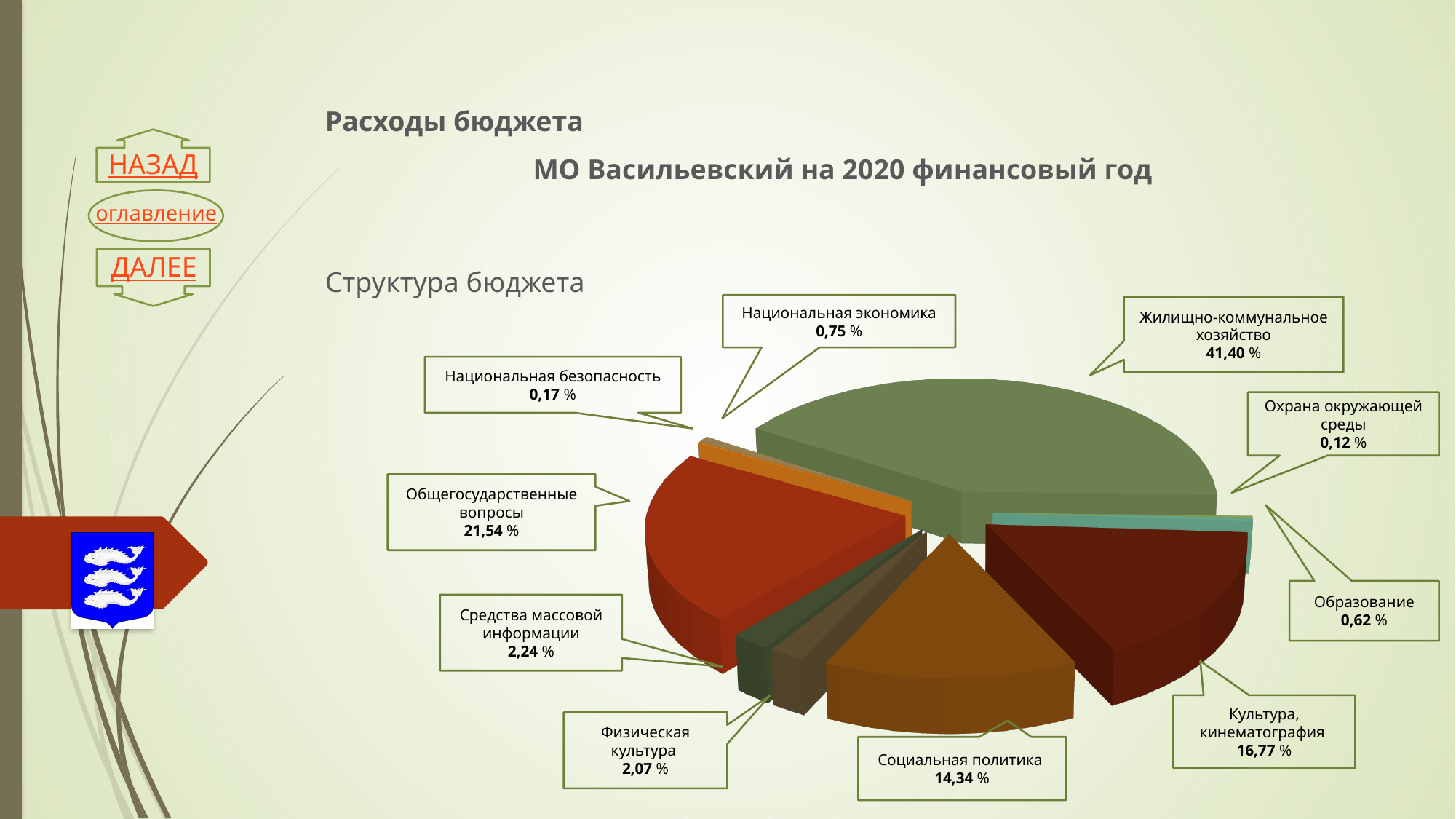
How many categories are shown in the pie chart? 10 What kind of chart is shown on the slide? pie chart What share of the budget goes to Жилищно-коммунальное хозяйство? 41,40 % Which category has the smallest share of the budget? Охрана окружающей среды What is the difference in percentage points between Жилищно-коммунальное хозяйство and Общегосударственные вопросы? 19,86 What share of the budget goes to Национальная безопасность? 0,17 % What is the heading above the pie chart? Структура бюджета What share of the budget goes to Социальная политика? 14,34 % What share of the budget goes to Общегосударственные вопросы? 21,54 % Which has a larger share: Средства массовой информации or Физическая культура? Средства массовой информации What is the difference in percentage points between Культура, кинематография and Социальная политика? 2,43 Which category has the largest share of the budget? Жилищно-коммунальное хозяйство